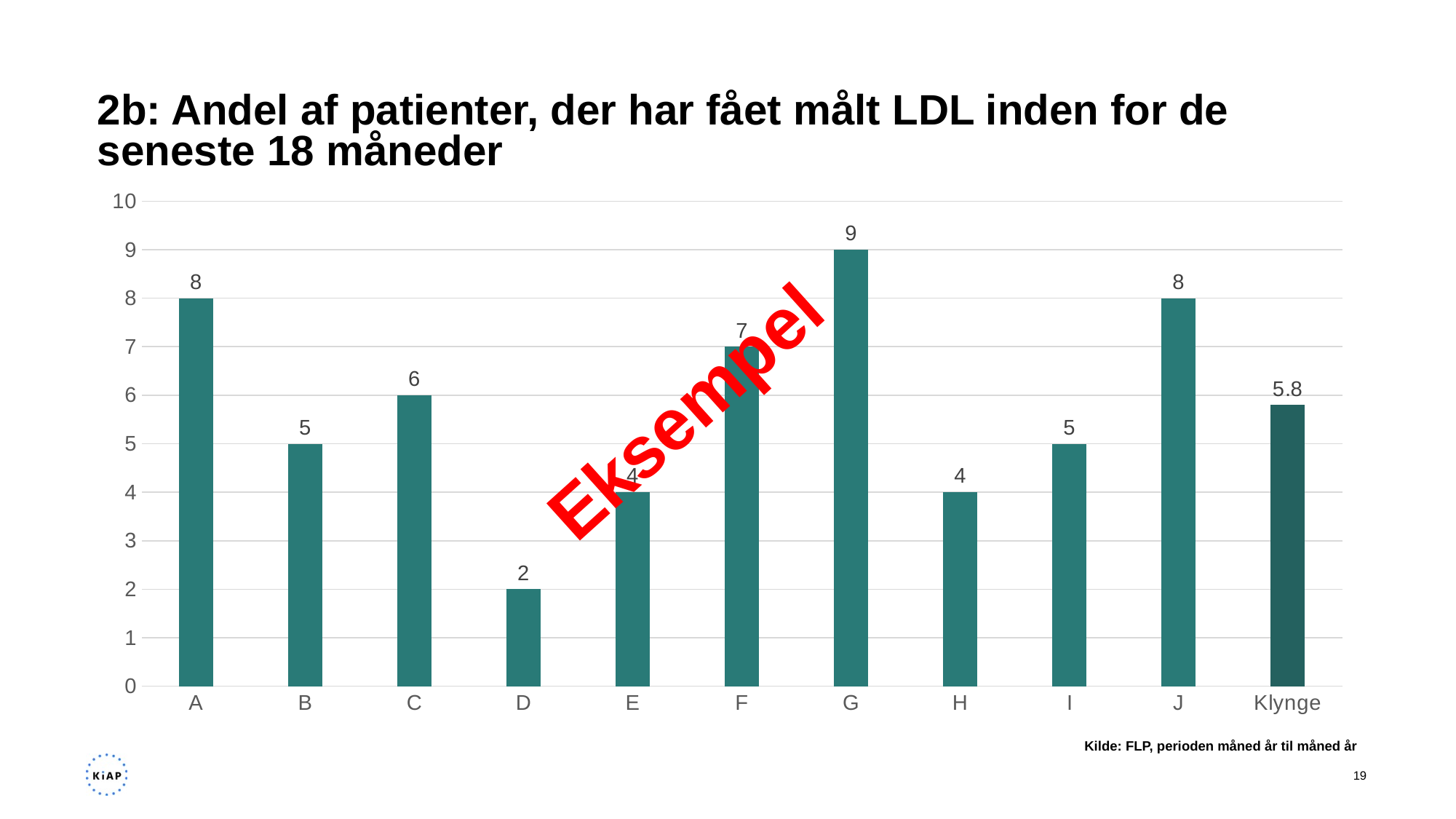
What is the difference between the values for G and D? 7 Which category has the lowest value? D Which is larger, the value for C or the value for H? C What is the value for Klynge? 5.8 What kind of chart is shown on the slide? Bar chart What is the value for category D? 2 What is the value for category G? 9 What is the difference between the values for J and Klynge? 2.2 Is the value for F greater or less than 5? greater What is the source cited below the chart? Kilde: FLP, perioden måned år til måned år Which category has the highest value? G How many categories are shown on the x axis? 11